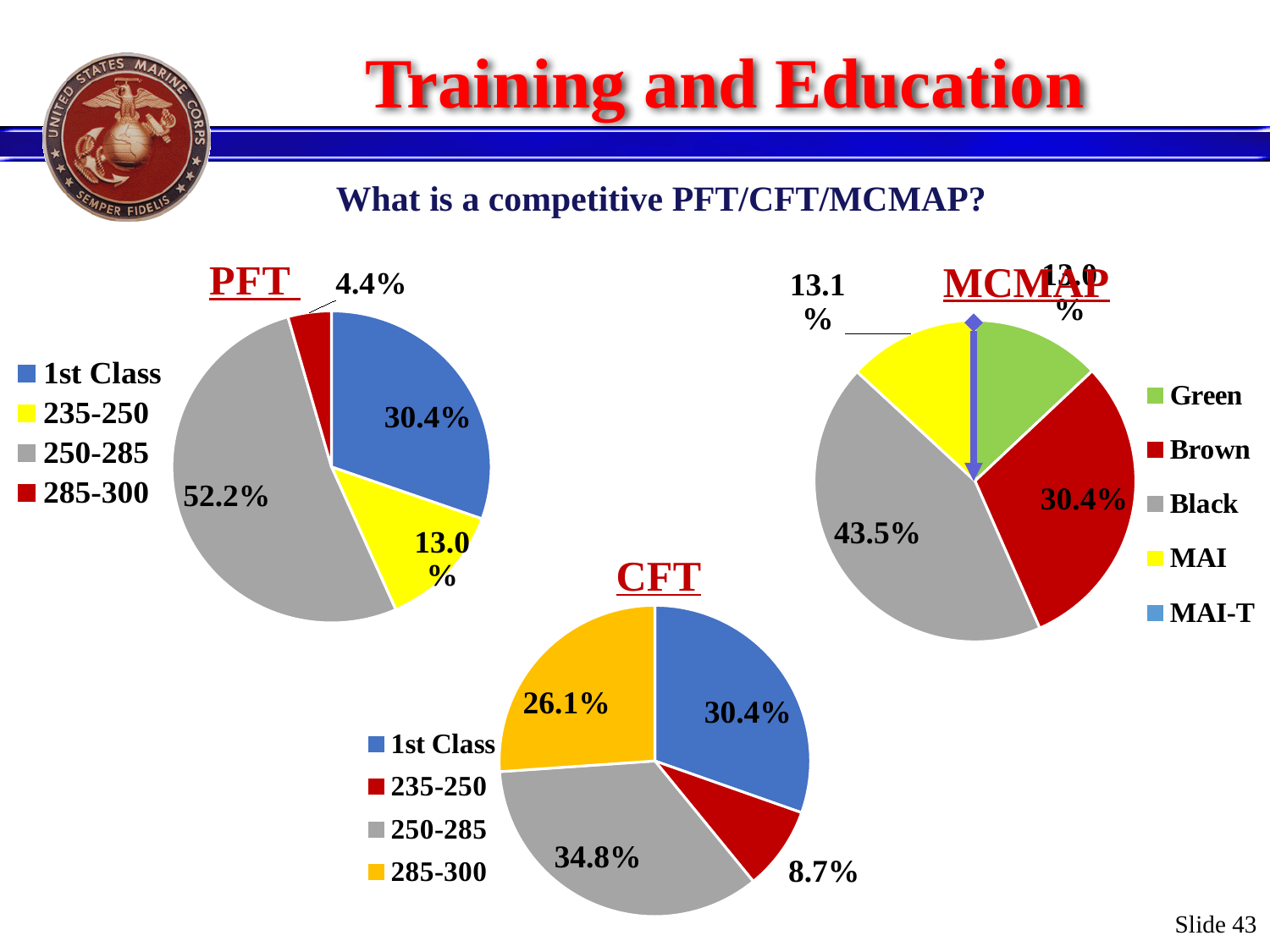
In the CFT pie chart, what percentage is shown for the 235-250 slice? 8.7% In the PFT pie chart, which category has the largest share? 250-285 In the MCMAP pie chart, what percentage is shown for the Brown slice? 30.4% In the CFT pie chart, which category has the largest share? 250-285 In the CFT pie chart, what is the difference in percentage points between the 250-285 slice and the 1st Class slice? 4.4 In the CFT pie chart, what percentage is shown for the 285-300 slice? 26.1% In the PFT pie chart, what percentage is shown for the 250-285 slice? 52.2% In the PFT pie chart, what percentage is shown for the 285-300 slice? 4.4% How many entries does the legend of the MCMAP pie chart list? 5 In the MCMAP pie chart, what percentage is shown for the Black slice? 43.5% In the PFT pie chart, which category has the smallest share? 285-300 What type of chart is used for the CFT data? Pie chart